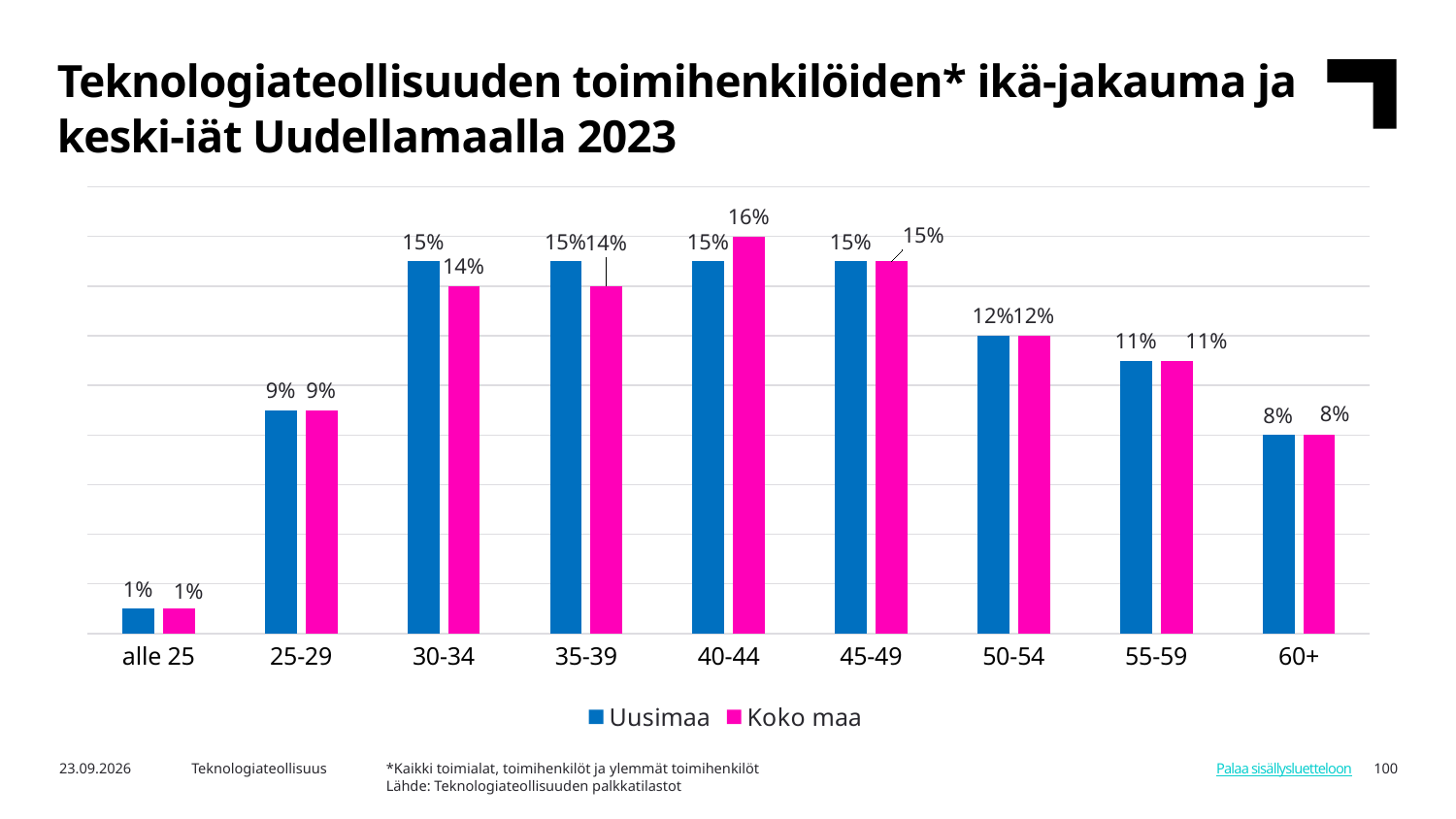
What is the value for Koko maa in the 35-39 age group? 14% In the 30-34 age group, which is larger: Uusimaa or Koko maa? Uusimaa How many age categories are shown on the x axis? 9 Which age group has the highest value for Koko maa? 40-44 What kind of chart is shown on the slide? bar chart What is the difference between the Koko maa and Uusimaa values in the 40-44 age group? 1% Which series is shown in pink? Koko maa What is the value for Uusimaa in the 30-34 age group? 15% What is the value for Koko maa in the 60+ age group? 8% How many series does the legend list? 2 Which age group has the lowest value for Uusimaa? alle 25 Do the Uusimaa values rise or fall from the 50-54 age group to the 60+ age group? fall